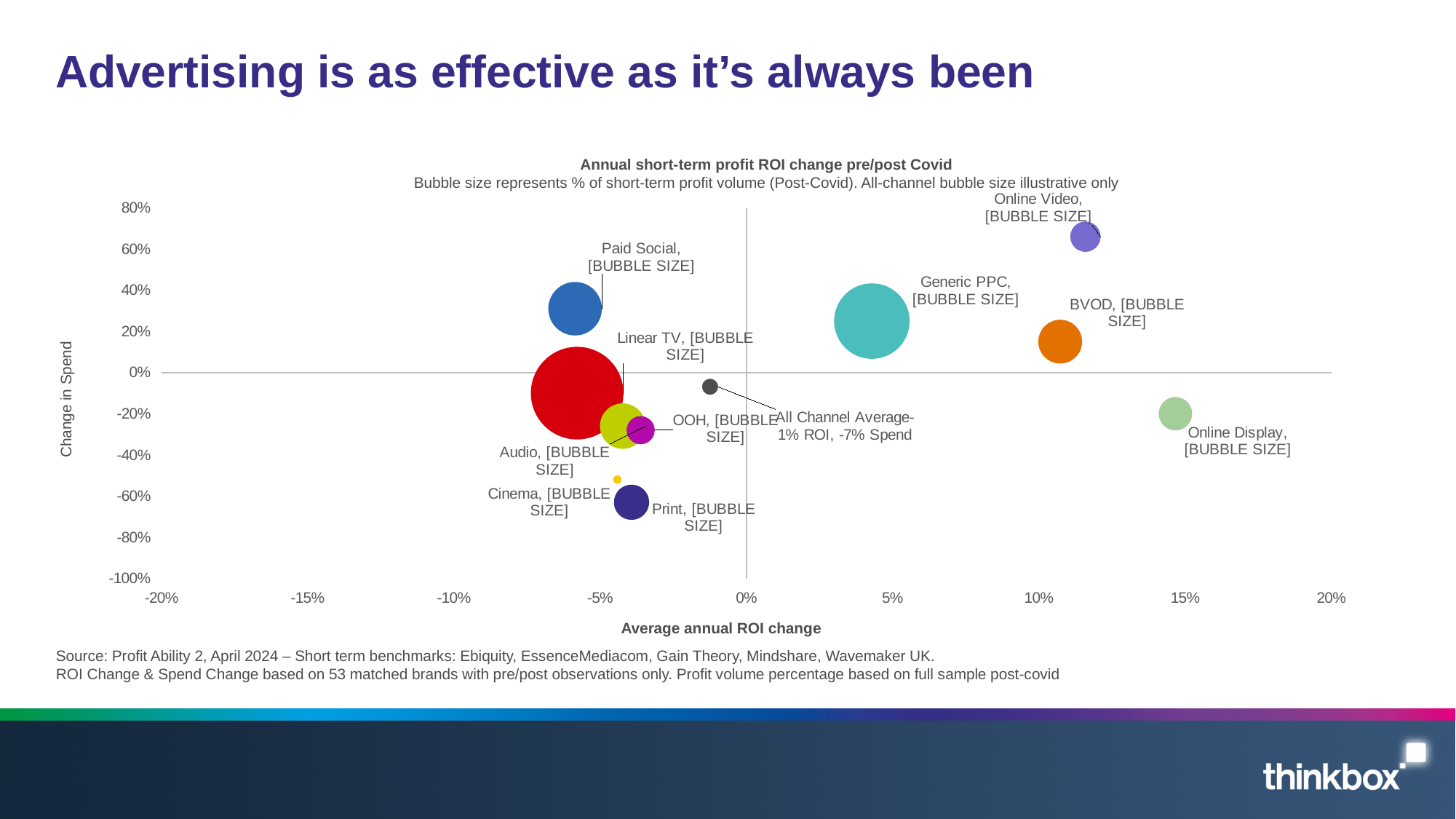
Which channel has the highest average annual ROI change? Online Display Is the average annual ROI change for Online Display greater or less than 10%? greater Is the change in spend for Paid Social greater or less than 20%? greater What is the title of the chart? Annual short-term profit ROI change pre/post Covid Which has the higher change in spend, Generic PPC or Online Display? Generic PPC Which channel has the largest bubble? Linear TV Which channel has the highest change in spend? Online Video What is the average annual ROI change for the All Channel Average point? -1% Which channel has the lowest change in spend? Print What kind of chart is shown on the slide? Bubble chart What is the change in spend for the All Channel Average point? -7% What is the label of the horizontal axis of the chart? Average annual ROI change